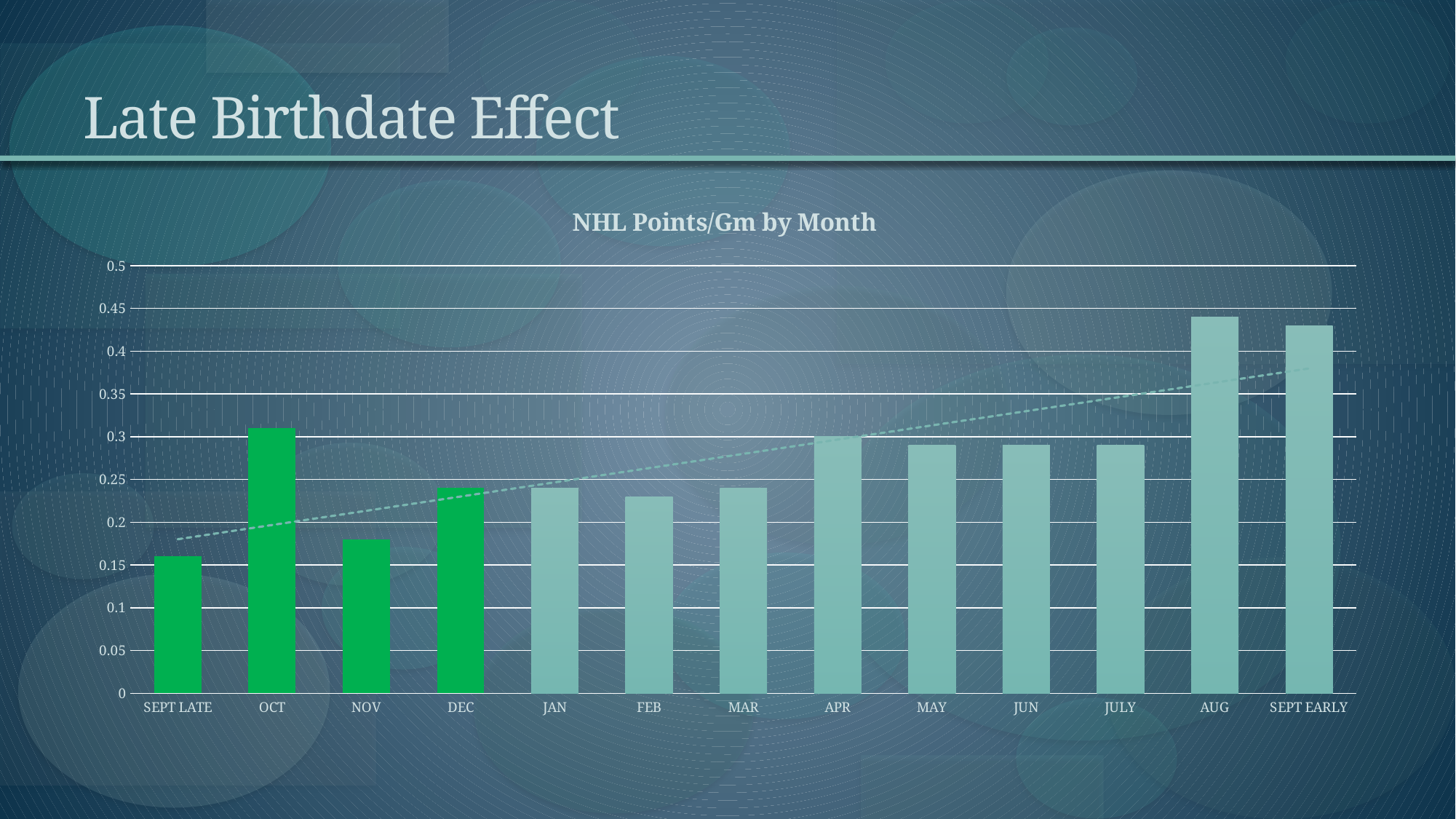
Is the value for FEB greater or less than 0.25? less Which has the higher value, AUG or JAN? AUG Which has the higher value, OCT or NOV? OCT Is the value for SEPT LATE greater or less than 0.2? less According to the dashed trend line, do values generally rise or fall from SEPT LATE to SEPT EARLY? Rise What is the title of the chart? NHL Points/Gm by Month Is the value for OCT greater or less than 0.25? greater Which months' bars are highlighted in bright green? SEPT LATE, OCT, NOV, DEC Which month has the lowest points per game? SEPT LATE How many months (categories) are plotted on the x axis? 13 What kind of chart is shown on the slide? Bar chart